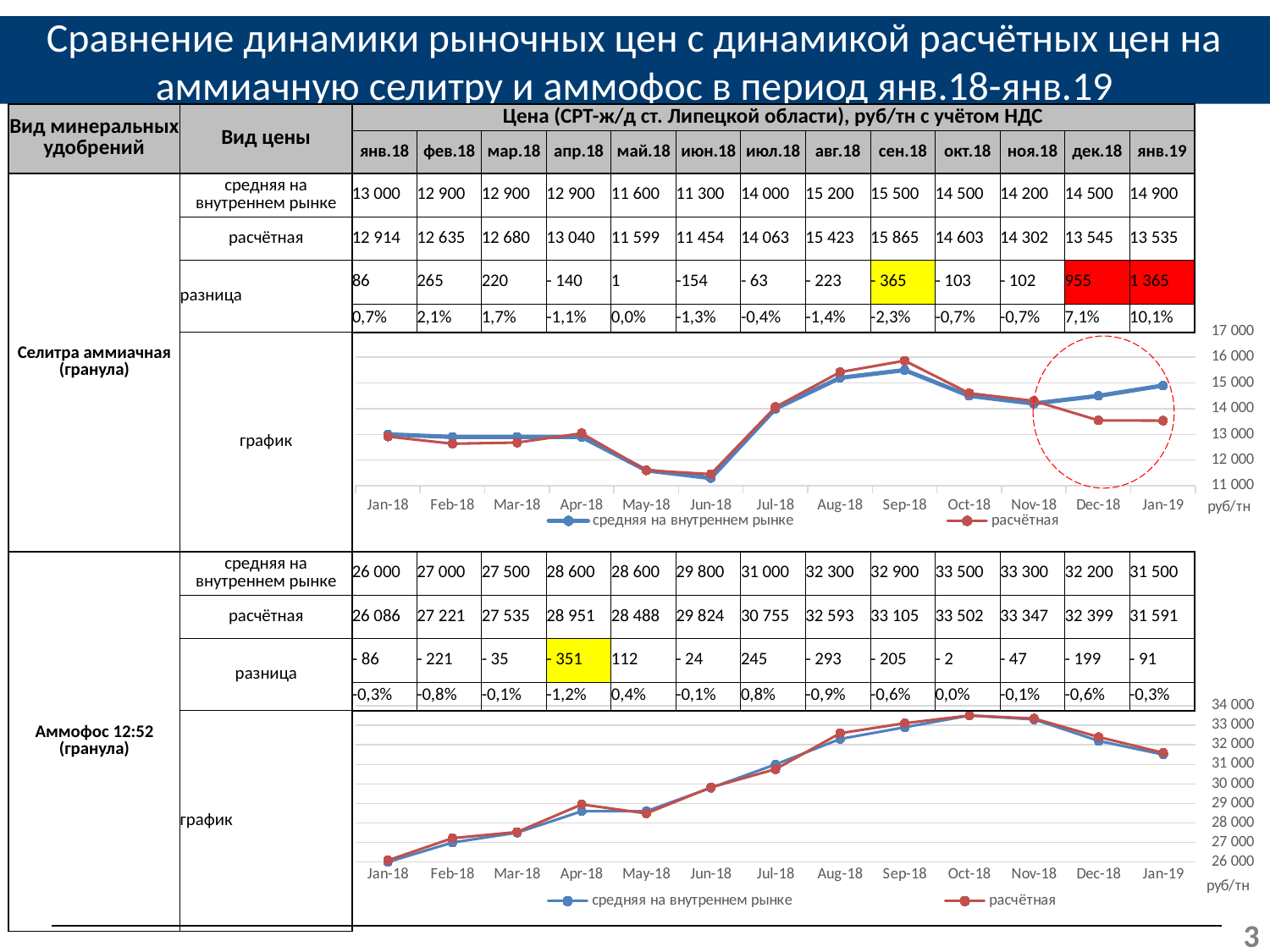
In the top chart (Селитра аммиачная), what is the value of 'расчётная' for Jan-19? 13 535 In the top chart (Селитра аммиачная), what is the difference between 'средняя на внутреннем рынке' and 'расчётная' in Dec-18? 955 In the top chart (Селитра аммиачная), which series is higher in Jan-19? средняя на внутреннем рынке What type of chart is the top chart (Селитра аммиачная)? line chart In the bottom chart (Аммофос 12:52), in which month does 'средняя на внутреннем рынке' reach its highest value? Oct-18 In the top chart (Селитра аммиачная), in which month is the 'расчётная' series highest? Sep-18 In the bottom chart (Аммофос 12:52), is the 'средняя на внутреннем рынке' value for Jan-18 greater or less than 27 000? less In the top chart (Селитра аммиачная), what is the value of 'средняя на внутреннем рынке' for Sep-18? 15 500 In the bottom chart (Аммофос 12:52), do the values of 'средняя на внутреннем рынке' rise or fall from Jan-18 to Oct-18? rise In the top chart (Селитра аммиачная), in which month is the 'средняя на внутреннем рынке' series lowest? Jun-18 How many series does the legend of the top chart (Селитра аммиачная) list? 2 How many months are plotted along the x axis of the bottom chart (Аммофос 12:52)? 13